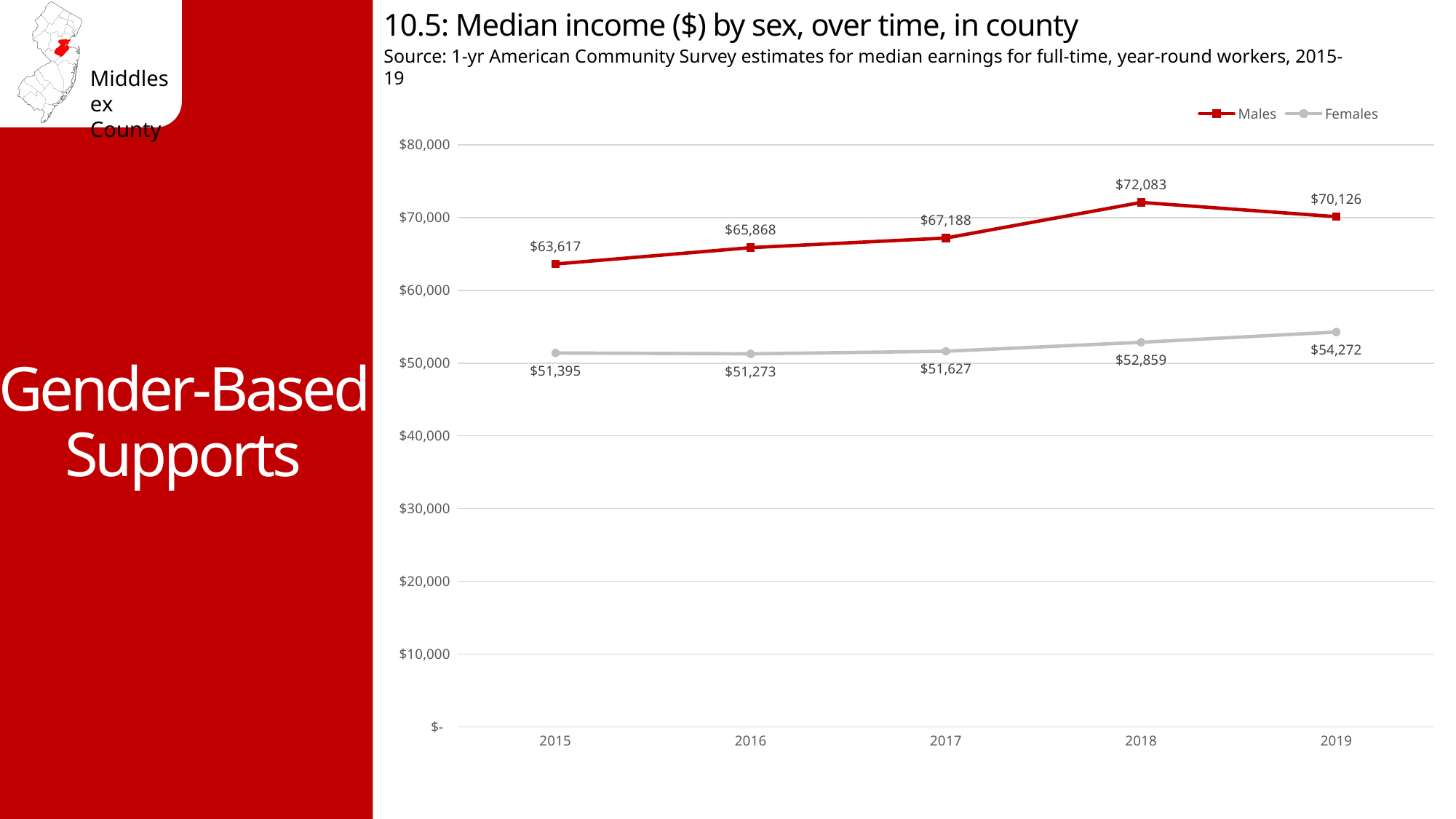
What is the difference between the Males and Females median income in 2019? $15,854 How many years are plotted on the x axis? 5 Which series had the higher median income in 2015, Males or Females? Males What kind of chart is shown on the slide? line chart Is the median income for Females in 2019 greater or less than $60,000? less Did the median income for Females rise or fall from 2017 to 2019? rise What colour is the line for Males? red In which year was the median income for Males highest? 2018 What was the median income for Females in 2016? $51,273 In which year was the median income for Females lowest? 2016 What was the median income for Males in 2018? $72,083 How many series does the legend list? 2